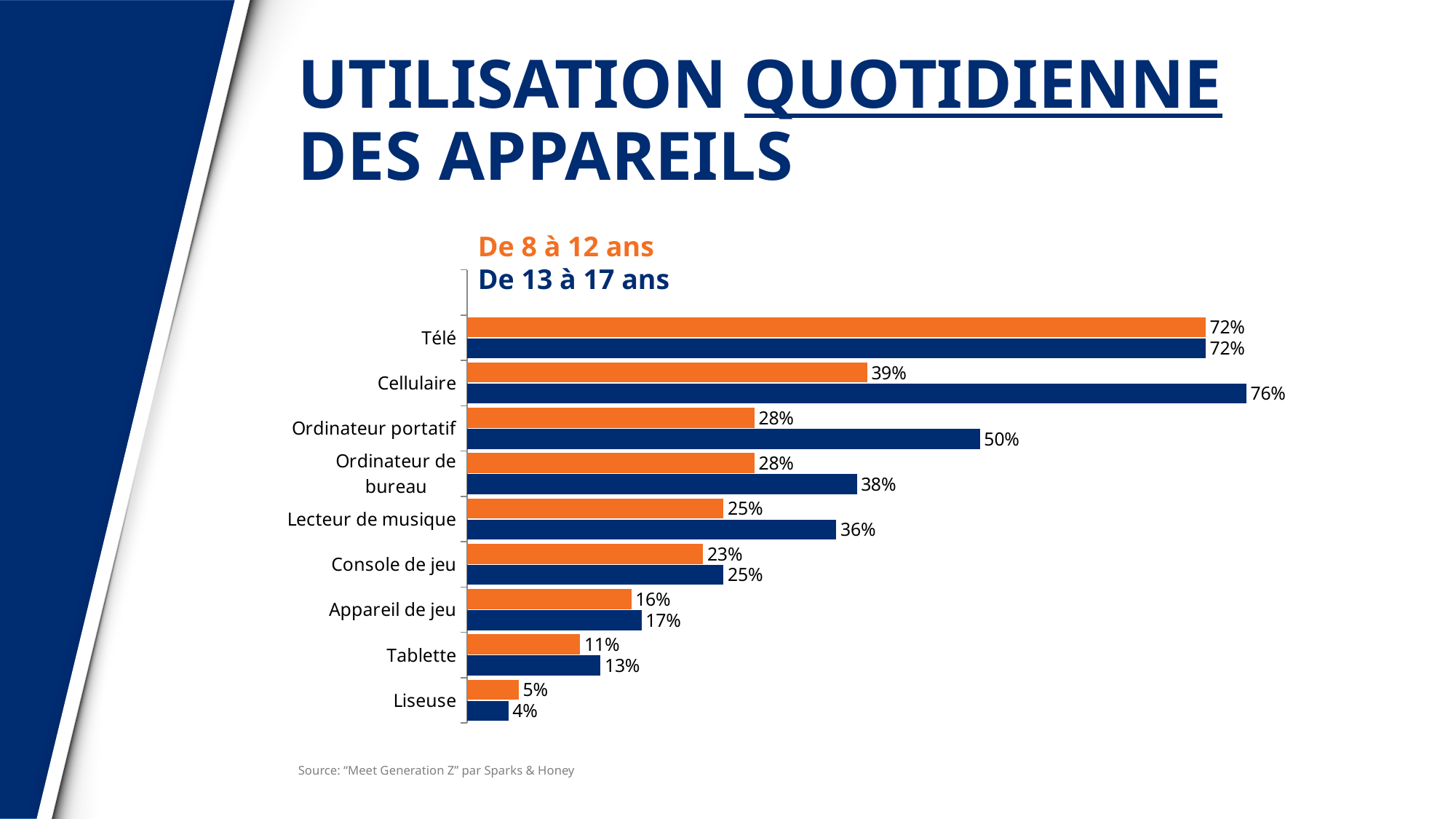
What is the value for Tablette in the De 13 à 17 ans series? 13% Which is larger for Liseuse: the De 8 à 12 ans value or the De 13 à 17 ans value? De 8 à 12 ans Which colour represents the De 8 à 12 ans series? Orange How many series does the legend list? 2 What kind of chart is shown on the slide? Bar chart Which category has the lowest value in the De 13 à 17 ans series? Liseuse What is the difference between the De 13 à 17 ans and De 8 à 12 ans values for Cellulaire? 37% What is the value for Ordinateur portatif in the De 8 à 12 ans series? 28% What is the value for Cellulaire in the De 13 à 17 ans series? 76% How many device categories are shown in the chart? 9 What is the difference between the De 13 à 17 ans and De 8 à 12 ans values for Ordinateur portatif? 22% Which category has the highest value in the De 8 à 12 ans series? Télé